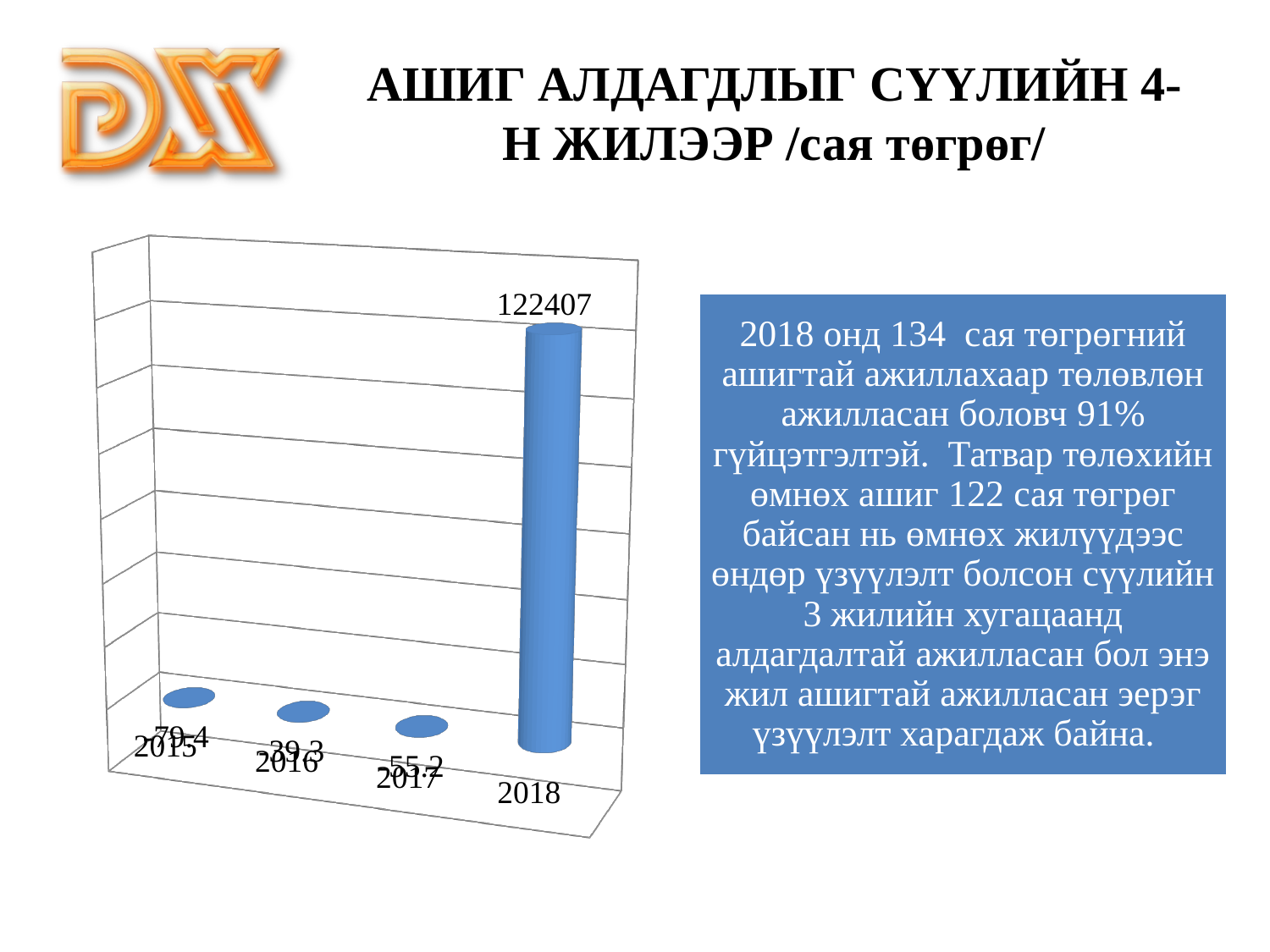
What is the title of the slide containing the chart? АШИГ АЛДАГДЛЫГ СҮҮЛИЙН 4-Н ЖИЛЭЭР /сая төгрөг/ What kind of chart is shown on the slide? bar chart How many years are shown on the x axis? 4 What is the value shown for 2018? 122407 What colour are the bars in the chart? blue Which is larger, the value for 2017 or the value for 2018? 2018 Which year has the highest value? 2018 Which is larger, the value for 2015 or the value for 2018? 2018